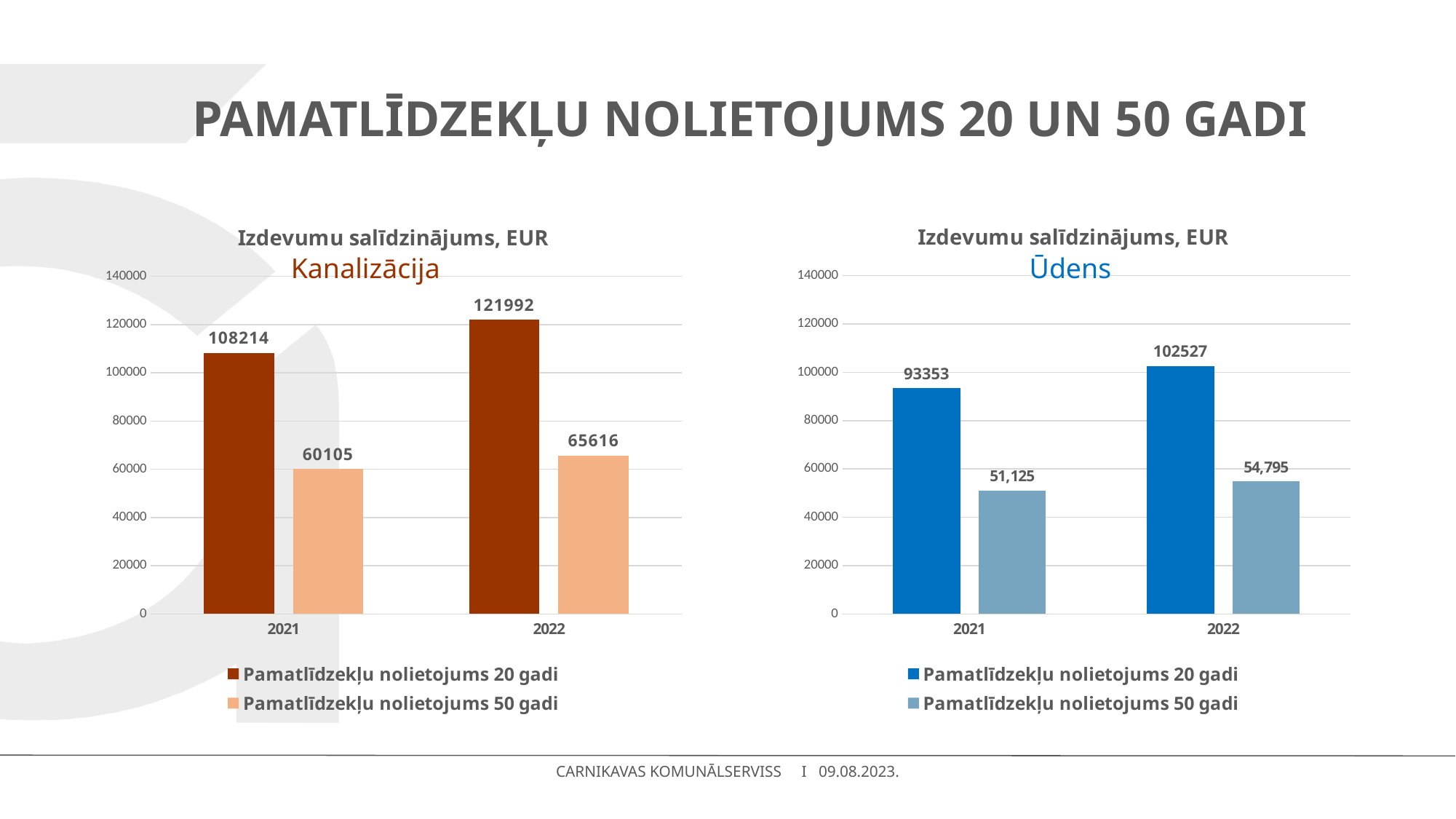
In the Kanalizācija chart, which year has the highest value for Pamatlīdzekļu nolietojums 20 gadi? 2022 In the Ūdens chart, what is the difference between the 20 gadi values for 2022 and 2021? 9174 Is the 2021 value for Pamatlīdzekļu nolietojums 20 gadi larger in the Kanalizācija chart or the Ūdens chart? Kanalizācija In the Ūdens chart, which bar has the lowest value? Pamatlīdzekļu nolietojums 50 gadi in 2021 How many series does the legend of the Kanalizācija chart list? 2 In the Ūdens chart, does the value for Pamatlīdzekļu nolietojums 50 gadi rise or fall from 2021 to 2022? rise In the Kanalizācija chart, what is the value for Pamatlīdzekļu nolietojums 20 gadi in 2022? 121992 In the Kanalizācija chart, what is the value for Pamatlīdzekļu nolietojums 50 gadi in 2021? 60105 In the Kanalizācija chart, what is the difference between the 20 gadi and 50 gadi values in 2022? 56376 In the Ūdens chart, what is the value for Pamatlīdzekļu nolietojums 50 gadi in 2022? 54,795 What kind of chart is the Ūdens chart? bar chart In the Ūdens chart, what is the value for Pamatlīdzekļu nolietojums 20 gadi in 2021? 93353